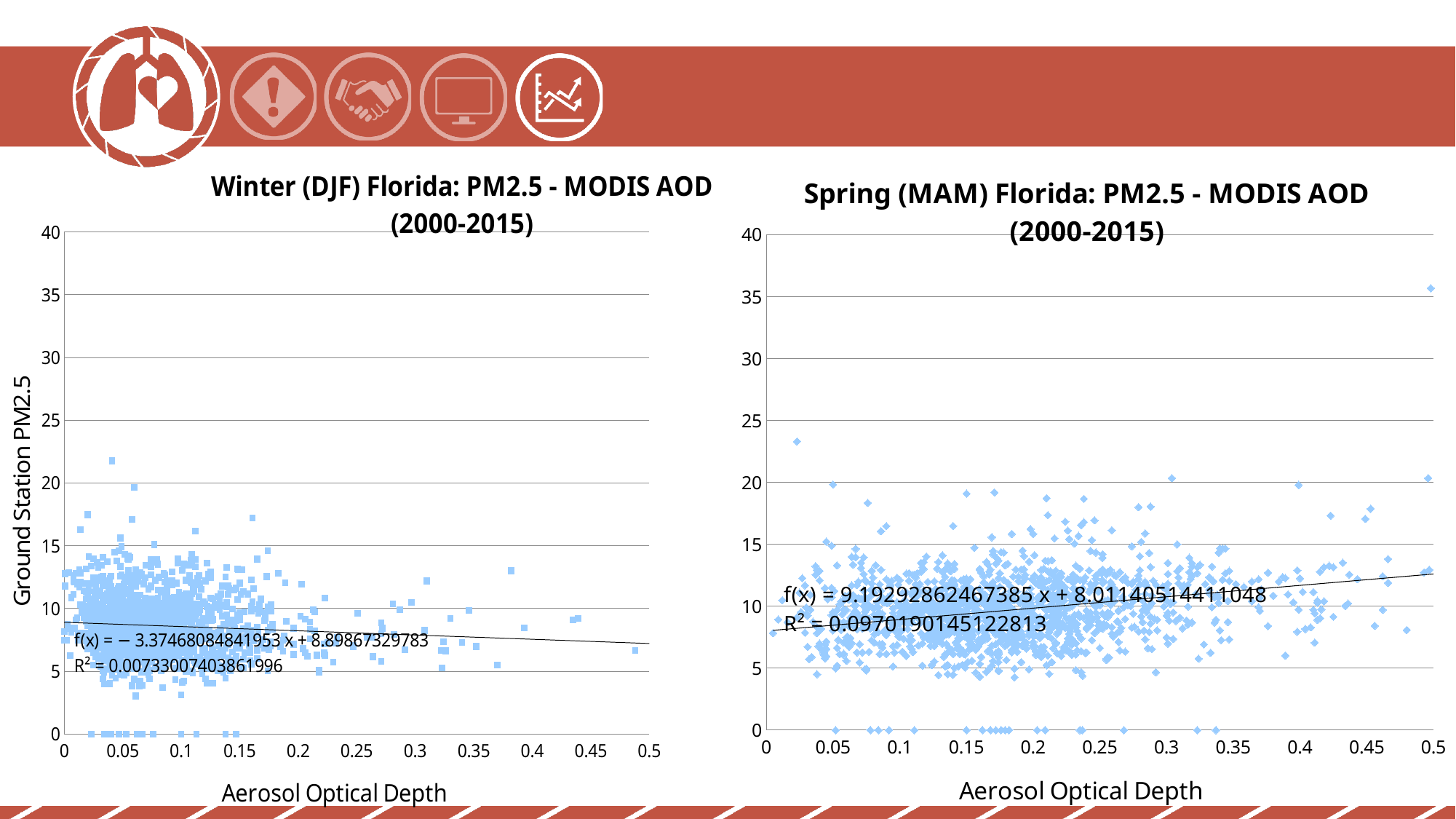
In the Winter (DJF) Florida chart, is the highest plotted PM2.5 value greater or less than 25? less In the Winter (DJF) Florida chart, does the fitted trend line rise or fall as Aerosol Optical Depth increases? fall In the Spring (MAM) Florida chart, what is the R² value printed on the chart? R² = 0.0970190145122813 In the Spring (MAM) Florida chart, is the highest plotted PM2.5 value greater or less than 30? greater What is the y-axis label on the Spring (MAM) Florida chart? Ground Station PM2.5 In the Winter (DJF) Florida chart, what is the trend line equation printed on the chart? f(x) = − 3.37468084841953 x + 8.89867329783 In the Spring (MAM) Florida chart, what is the trend line equation printed on the chart? f(x) = 9.19292862467385 x + 8.01140514411048 What type of chart is the Spring (MAM) Florida chart on the right? scatter chart What is the title of the chart on the left? Winter (DJF) Florida: PM2.5 - MODIS AOD (2000-2015) In the Winter (DJF) Florida chart, what is the R² value printed on the chart? R² = 0.00733007403861996 In the Spring (MAM) Florida chart, does the fitted trend line rise or fall as Aerosol Optical Depth increases? rise What type of chart is the Winter (DJF) Florida chart on the left? scatter chart